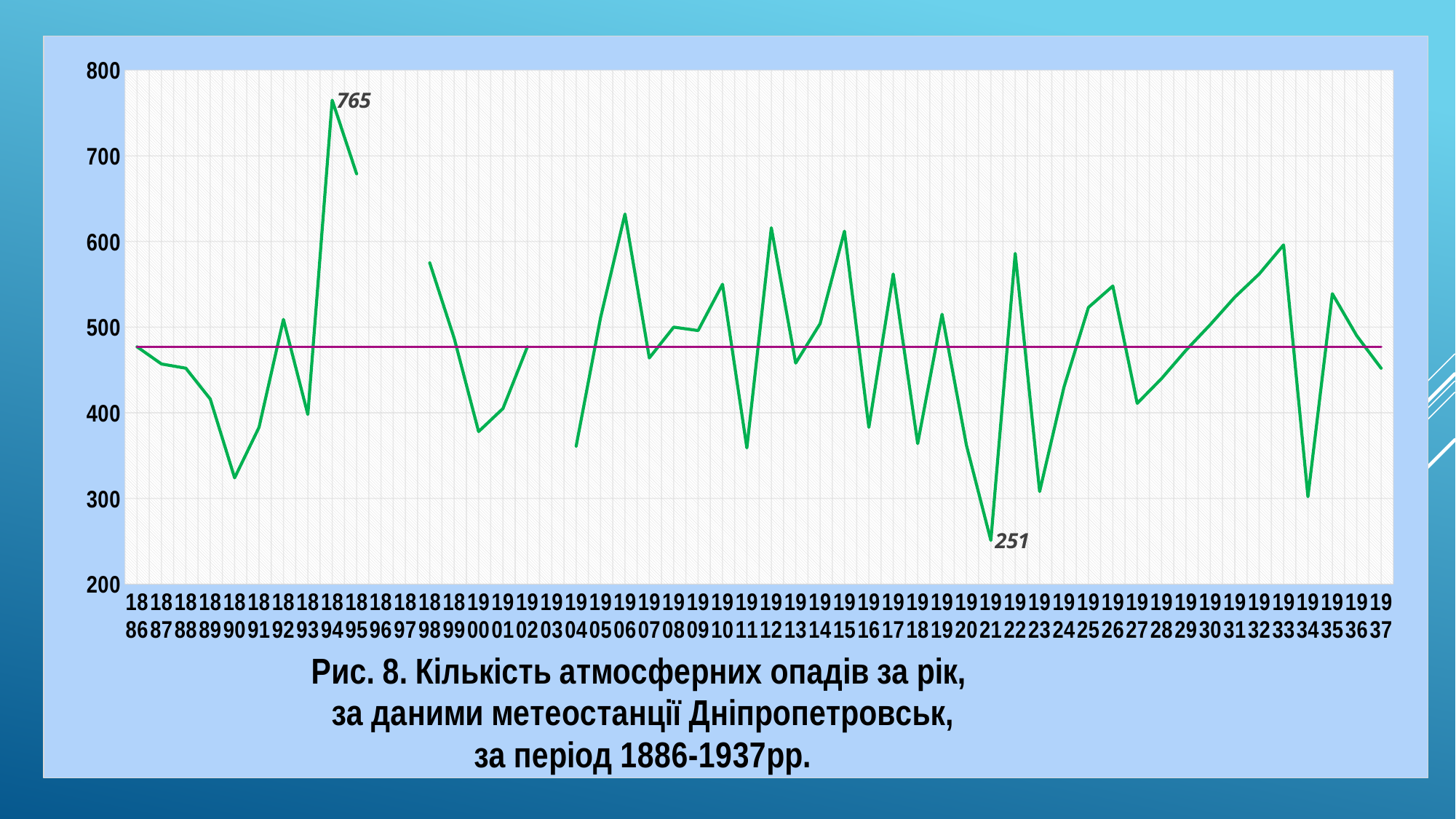
In which year does the chart reach its labelled minimum of 251? 1921 What colour is the data line on the chart? green What is the highest annual precipitation value labelled on the chart? 765 In which year does the chart reach its labelled maximum of 765? 1894 Is the value for 1906 greater or less than 600? greater What is the difference between the labelled maximum (765) and the labelled minimum (251)? 514 Is the value for 1890 greater or less than 400? less What type of chart is shown on the slide? line chart Is the value for 1934 greater or less than 400? less What is the lowest annual precipitation value labelled on the chart? 251 Which year has the larger precipitation value, 1894 or 1921? 1894 Do the values rise or fall along the x axis from 1886 to 1890? fall